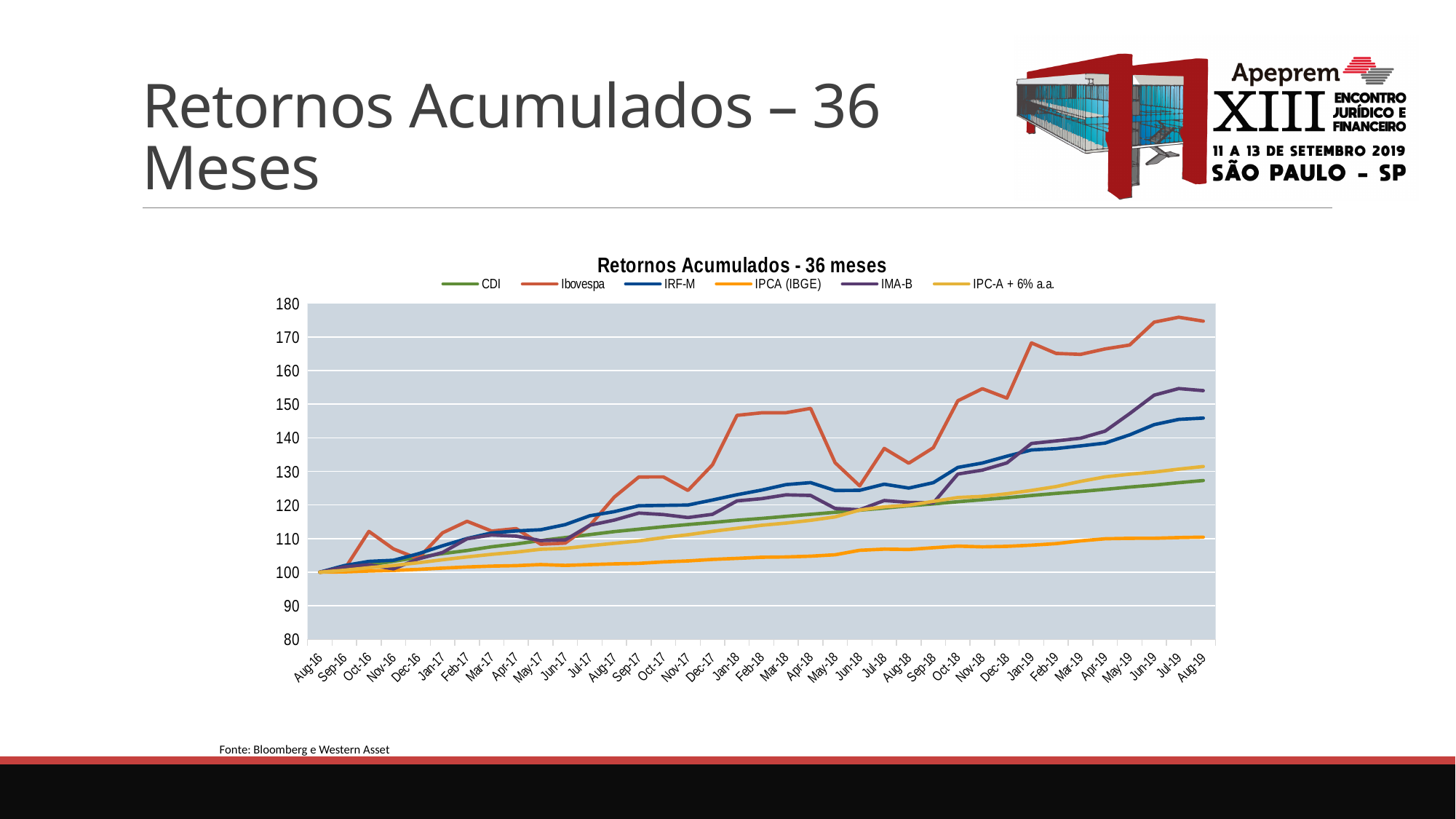
How many series does the legend of the chart list? 6 Which series has the lowest value at Aug-19? IPCA (IBGE) Which is larger at Aug-19, IMA-B or IRF-M? IMA-B What value do all series start at in Aug-16? 100 Which series has the highest value at Aug-19? Ibovespa Is the value for Ibovespa at Aug-19 greater or less than 170? greater Is the value for IMA-B at Aug-19 greater or less than 150? greater What kind of chart is shown on the slide? line chart Is the value for IRF-M at Aug-19 greater or less than 140? greater What is the title of the chart? Retornos Acumulados - 36 meses Does the CDI series rise or fall from Aug-16 to Aug-19? rise